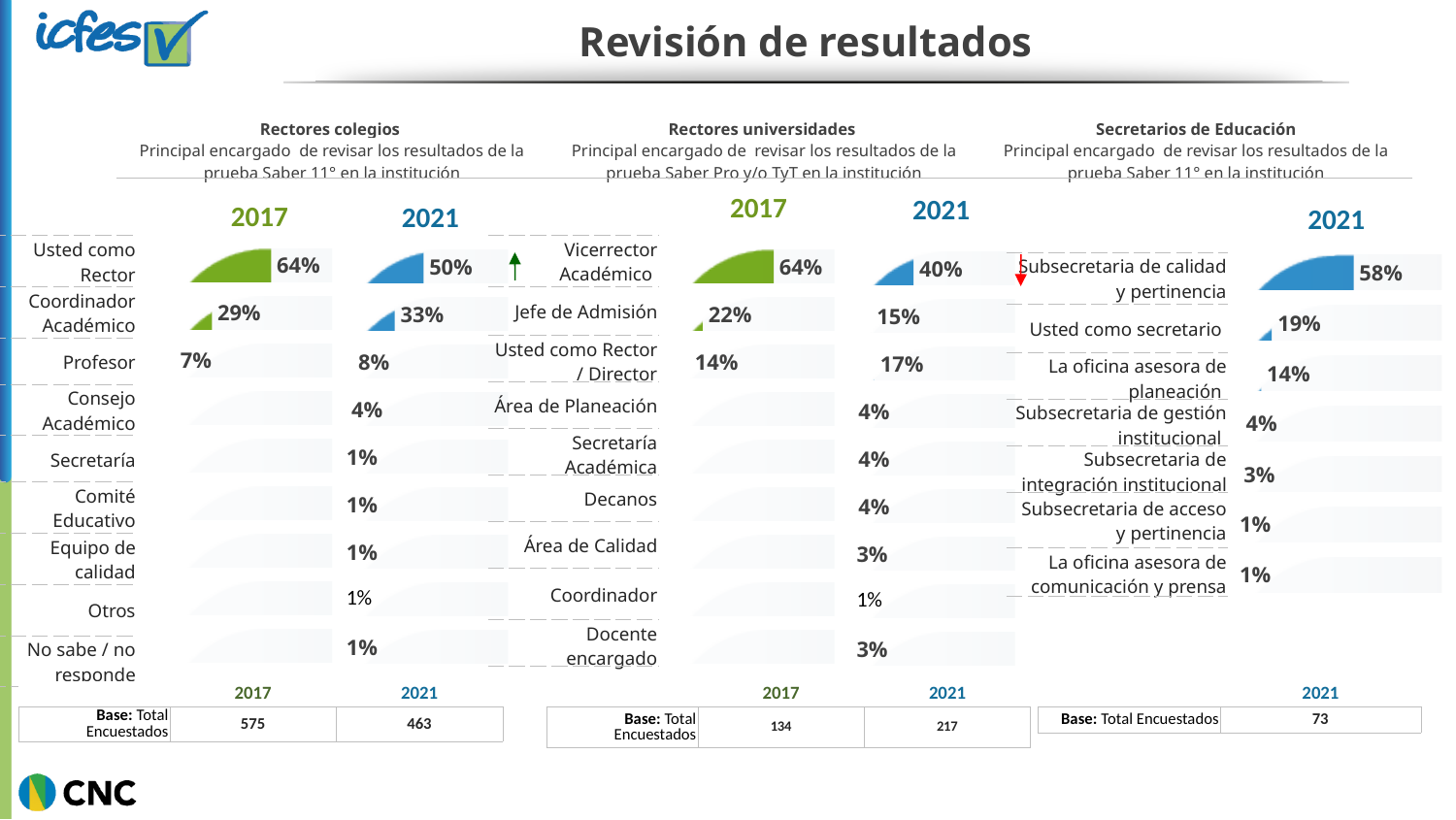
In the Rectores colegios chart, what percentage is shown for 'Usted como Rector' in 2021? 50% In the Rectores colegios chart, what percentage is shown for 'Coordinador Académico' in 2017? 29% In the Rectores universidades chart, what percentage is shown for 'Jefe de Admisión' in 2017? 22% Which years are compared in the Rectores colegios chart? 2017 and 2021 In the Rectores colegios chart, what is the difference between the 2017 and 2021 values for 'Usted como Rector'? 14 percentage points In the Secretarios de Educación chart, what percentage is shown for 'Subsecretaria de calidad y pertinencia' in 2021? 58% In the Rectores universidades chart, which category has the highest value in 2021? Vicerrector Académico What is the base (total encuestados) for Rectores colegios in 2021? 463 In the Rectores universidades chart, is the 2021 value for 'Usted como Rector / Director' larger or smaller than its 2017 value? larger How many categories are listed in the Secretarios de Educación chart? 7 In the Secretarios de Educación chart, which category has the lowest value, 'Usted como secretario' or 'La oficina asesora de planeación'? La oficina asesora de planeación What is the base (total encuestados) for Rectores universidades in 2017? 134